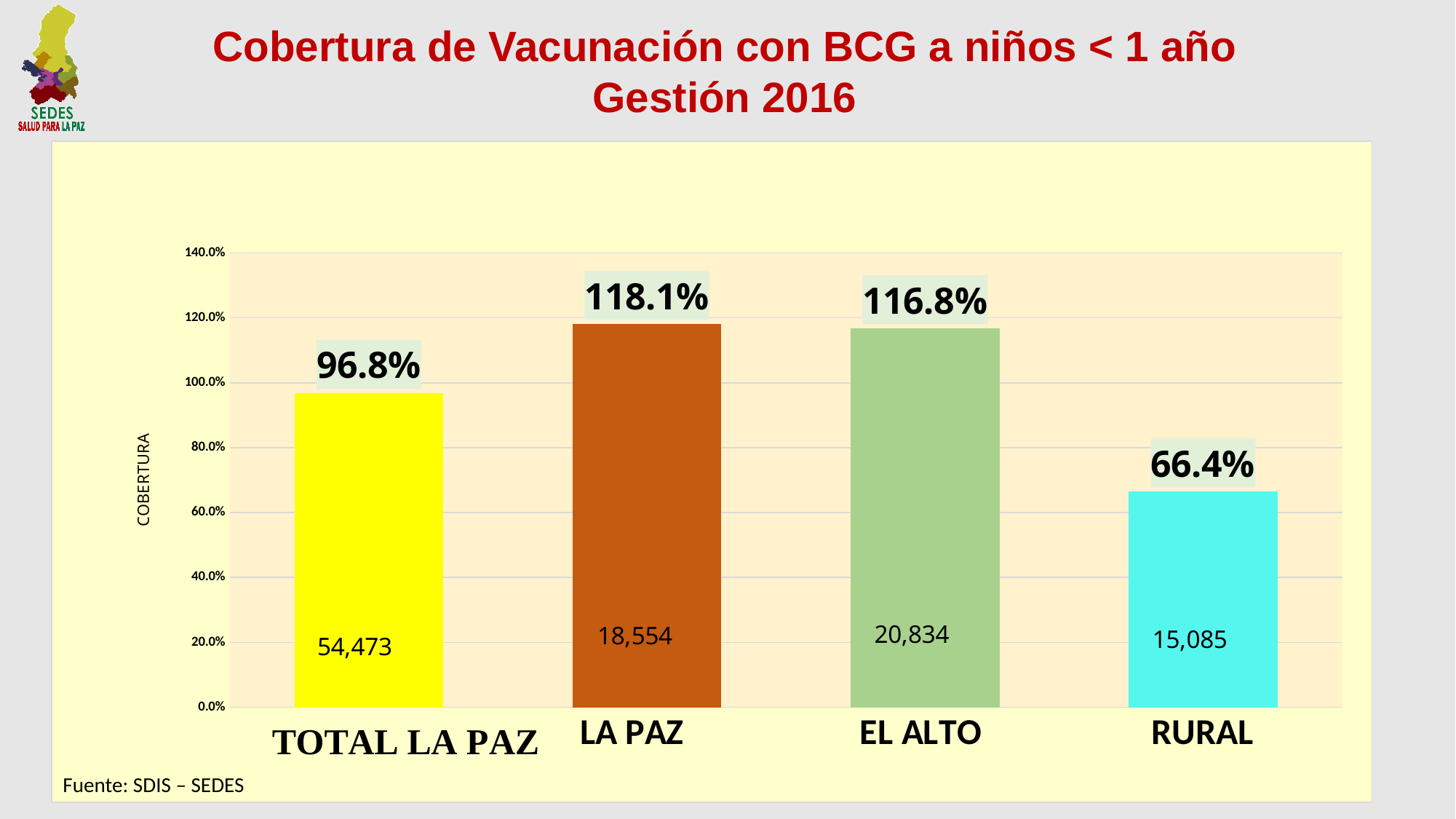
Is the coverage for TOTAL LA PAZ greater or less than 100.0%? less What is the coverage value for LA PAZ? 118.1% What is the coverage value for TOTAL LA PAZ? 96.8% Which has higher coverage, TOTAL LA PAZ or RURAL? TOTAL LA PAZ What is the difference in coverage between LA PAZ and EL ALTO? 1.3% What kind of chart is shown on the slide? bar chart Which category has the highest coverage? LA PAZ Which category has the lowest coverage? RURAL How many categories are shown on the x axis? 4 What is the label of the vertical axis? COBERTURA What is the coverage value for RURAL? 66.4% What number is printed inside the EL ALTO bar? 20,834